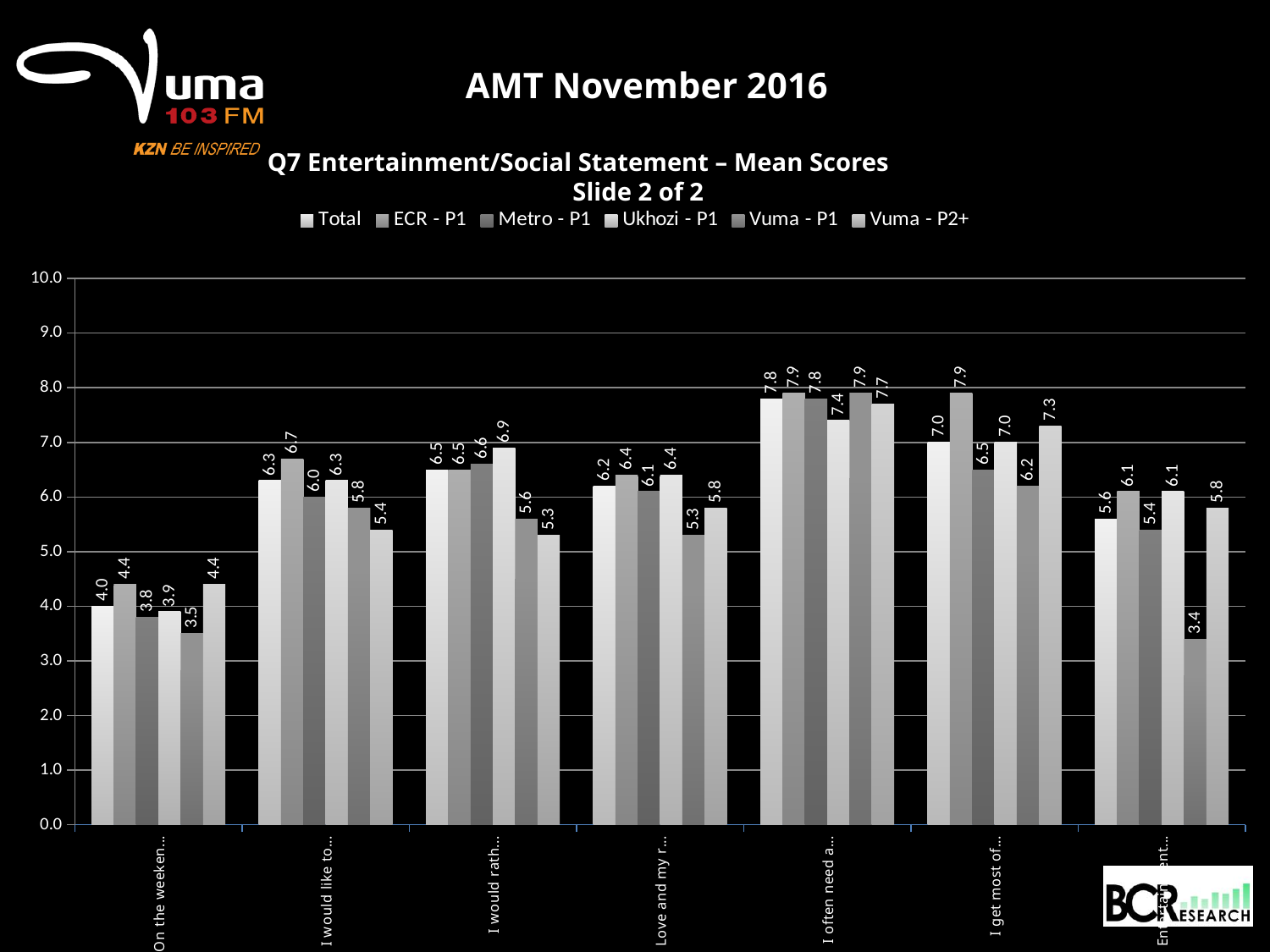
For the statement beginning "I would like to...", what is the difference between the ECR - P1 score and the Vuma - P1 score? 0.9 How many statement categories are plotted along the x axis? 7 What kind of chart is shown on the slide? bar chart What is the title of the chart? Q7 Entertainment/Social Statement – Mean Scores Slide 2 of 2 What is the Ukhozi - P1 mean score for the statement beginning "I would rath..."? 6.9 Which series has the highest mean score for the statement beginning "I get most of..."? ECR - P1 What is the Vuma - P2+ mean score for the statement beginning "I get most of..."? 7.3 What is the Total mean score for the statement beginning "On the weeken..."? 4.0 Which series has the lowest mean score for the statement beginning "On the weeken..."? Vuma - P1 How many series does the legend list? 6 For the statement beginning "Love and my r...", which is larger: the Vuma - P1 score or the Vuma - P2+ score? Vuma - P2+ Is the Metro - P1 value for the statement beginning "I often need a..." greater or less than 7.0? greater